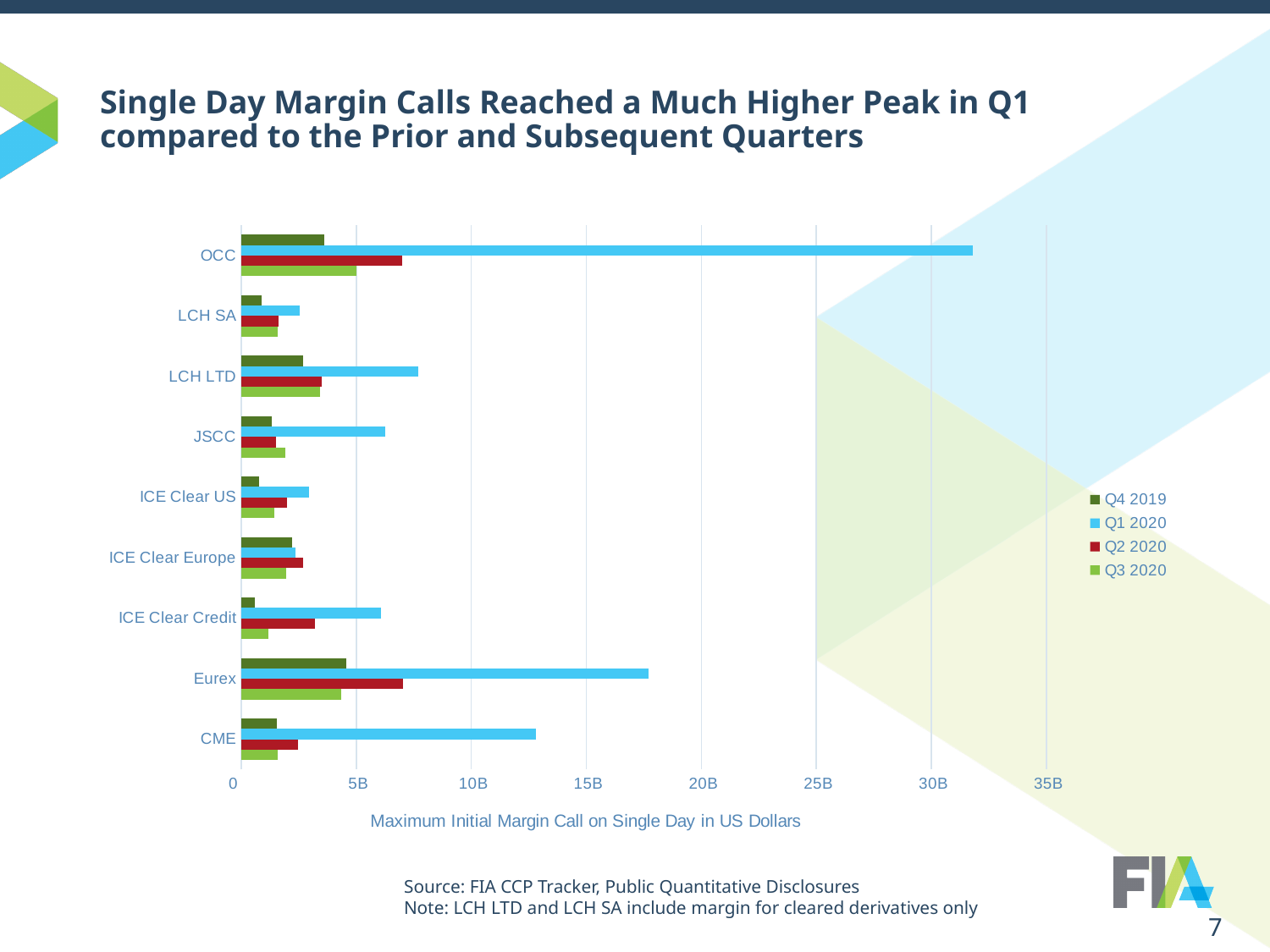
Which clearing house has the highest Q4 2019 value? Eurex What is the title of the horizontal axis? Maximum Initial Margin Call on Single Day in US Dollars Which clearing house has the highest Q1 2020 maximum initial margin call? OCC How many series does the chart's legend list? 4 Is the Q1 2020 value for CME greater or less than 10B? greater Is the Q1 2020 value for OCC greater or less than 30B? greater Is the Q1 2020 value for ICE Clear Europe greater or less than 5B? less Which series is shown in light blue according to the legend? Q1 2020 How many clearing houses (categories) are listed on the vertical axis of the chart? 9 What kind of chart is shown on the slide? Bar chart Which is larger for Q1 2020: the value for Eurex or the value for CME? Eurex